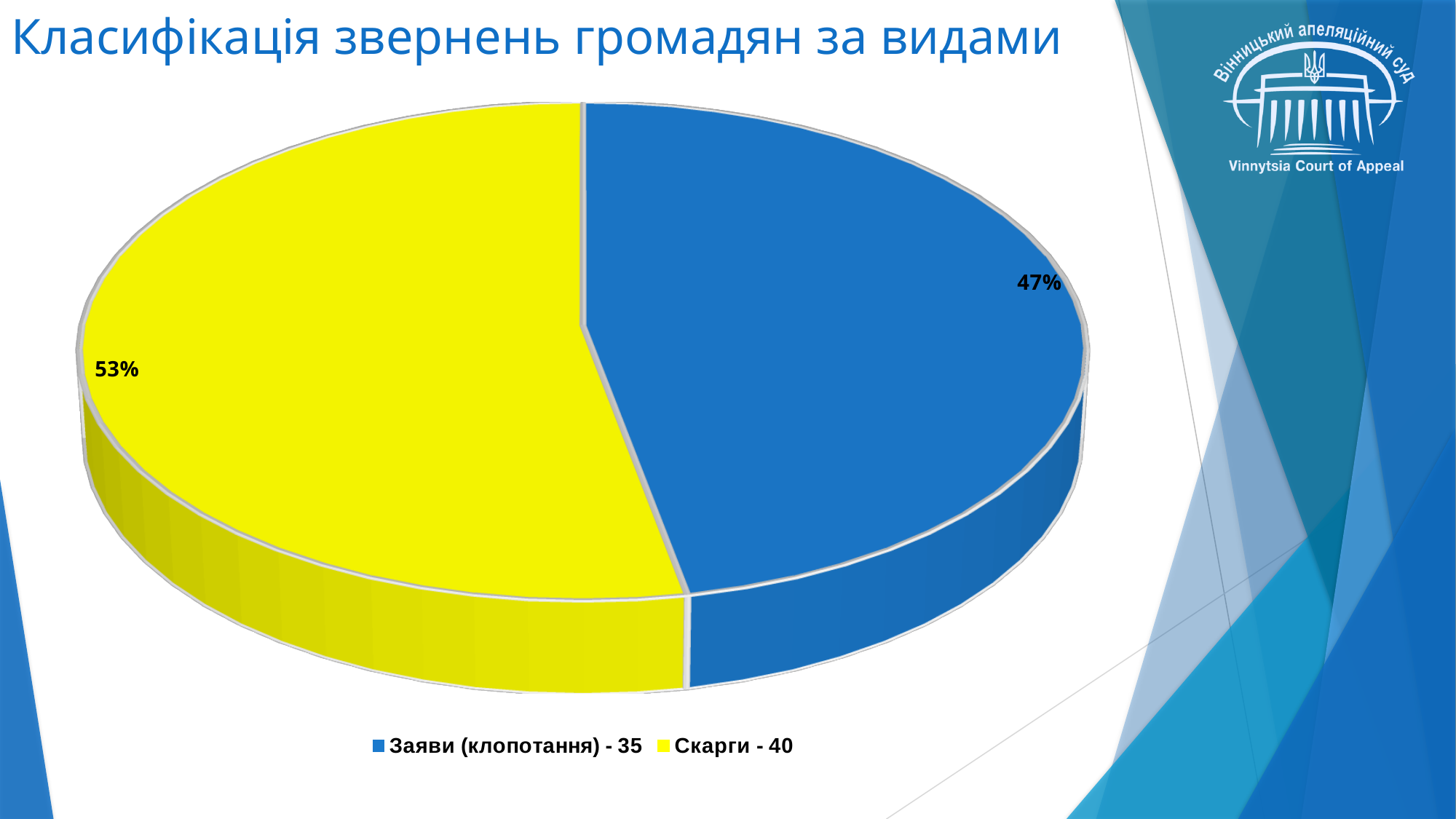
What colour is the slice for Скарги - 40? yellow What kind of chart is shown on the slide? pie chart Which is larger: the share for Скарги - 40 or the share for Заяви (клопотання) - 35? Скарги - 40 What percentage share does the slice for Скарги - 40 have? 53% How many entries does the legend list? 2 Which category has the smallest slice of the pie? Заяви (клопотання) - 35 How many slices does the pie chart have? 2 What is the title of the slide containing the chart? Класифікація звернень громадян за видами What is the difference in percentage points between the Скарги - 40 slice and the Заяви (клопотання) - 35 slice? 6% What percentage share does the slice for Заяви (клопотання) - 35 have? 47% Which category has the largest slice of the pie? Скарги - 40